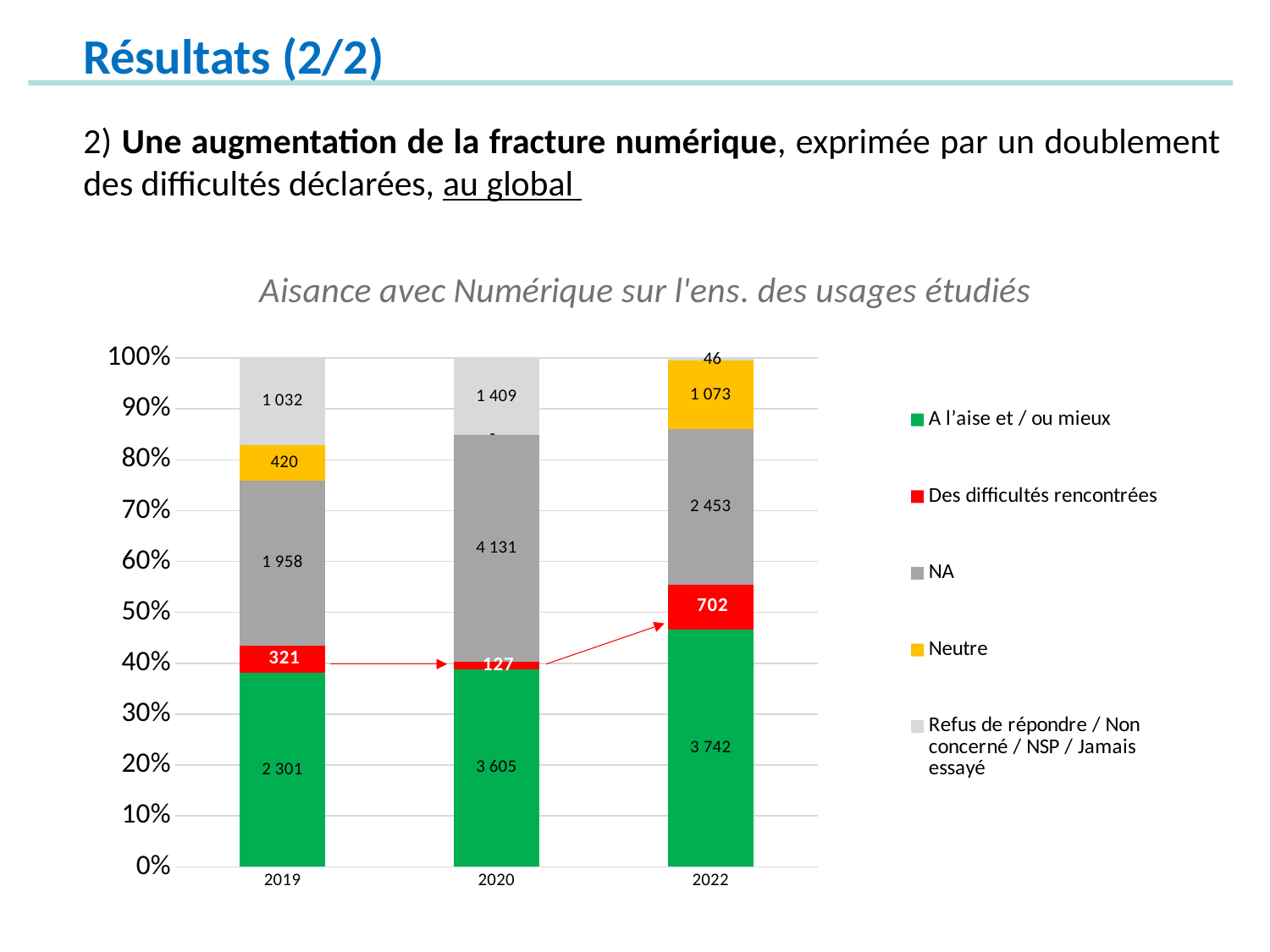
What is the value of the 'NA' segment for 2019? 1 958 What is the value of the 'A l’aise et / ou mieux' segment for 2020? 3 605 Which year has the lowest value for 'Des difficultés rencontrées'? 2020 Which year has the highest value for 'Des difficultés rencontrées'? 2022 How many series does the legend list? 5 How many years are shown on the x axis? 3 What is the value of the 'Neutre' segment for 2022? 1 073 What is the value of the 'Des difficultés rencontrées' segment for 2022? 702 What kind of chart is shown on the slide? Stacked bar chart What is the difference between the 'Des difficultés rencontrées' values for 2022 and 2019? 381 Which is larger, the 'NA' value for 2020 or for 2022? 2020 Is the share of 'A l’aise et / ou mieux' in the 2022 bar greater or less than 40%? greater